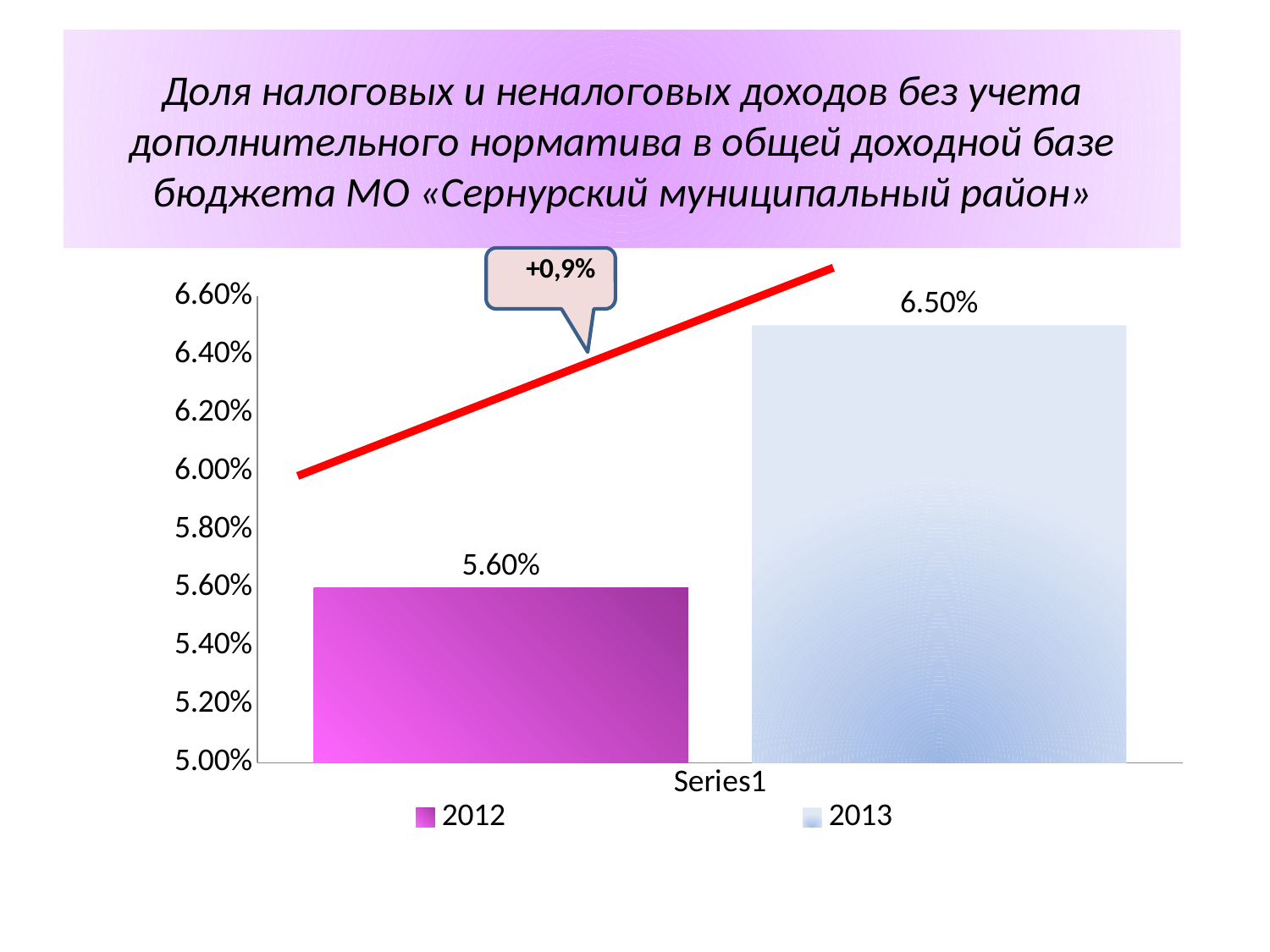
What is the value for 2013? 6.50% Does the value rise or fall from 2012 to 2013? rise What change is shown in the callout above the red arrow? +0,9% What is the difference between the 2013 and 2012 values? 0.90% Which year has the higher value, 2012 or 2013? 2013 What kind of chart is shown on the slide? bar chart Which year has the lowest value? 2012 What is the category label shown on the x axis? Series1 What is the value for 2012? 5.60% Is the value for 2013 greater or less than 6.00%? greater How many series does the legend list? 2 Is the value for 2012 greater or less than 6.00%? less